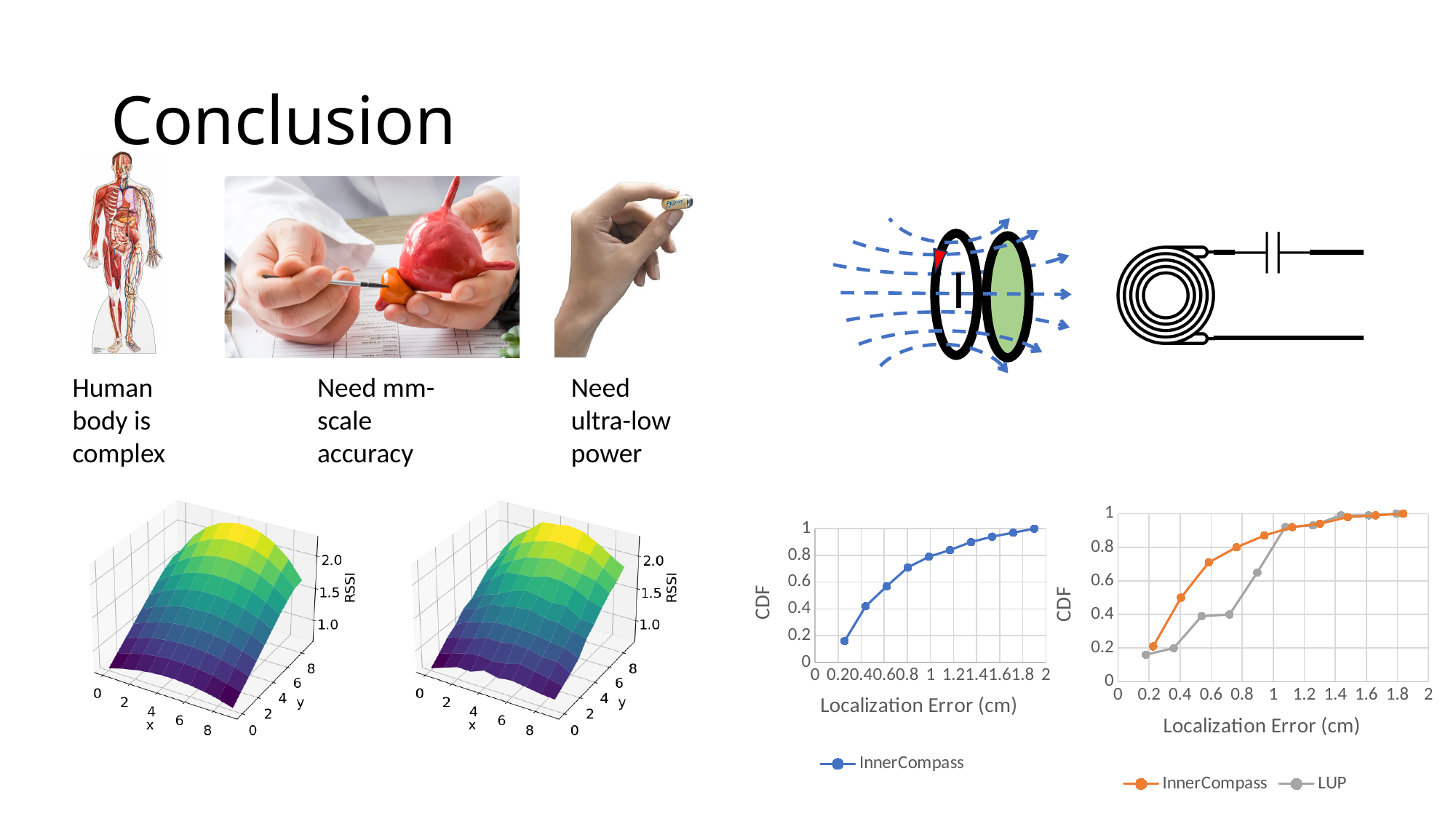
How many data points are plotted on the blue InnerCompass line in the CDF chart with a single series? 10 In the rightmost CDF chart, is the InnerCompass CDF value at a localization error of 0.8 cm greater or less than 0.6? greater In the CDF chart with the blue line, is the CDF value at a localization error of 1 cm greater or less than 0.6? greater What kind of chart is the rightmost chart on the slide (the one with the InnerCompass and LUP legend)? line chart How many series does the legend of the rightmost CDF chart list? 2 In the CDF chart with the blue line, do the CDF values rise or fall as Localization Error increases? rise What is the x-axis label of the rightmost CDF chart? Localization Error (cm) In the rightmost CDF chart, which series is plotted in orange? InnerCompass In the CDF chart with the blue line, is the CDF value at a localization error of 0.4 cm greater or less than 0.6? less How many series does the legend of the CDF chart with the blue line list? 1 In the rightmost CDF chart, at a localization error of 0.4 cm, which series has the higher CDF, InnerCompass or LUP? InnerCompass